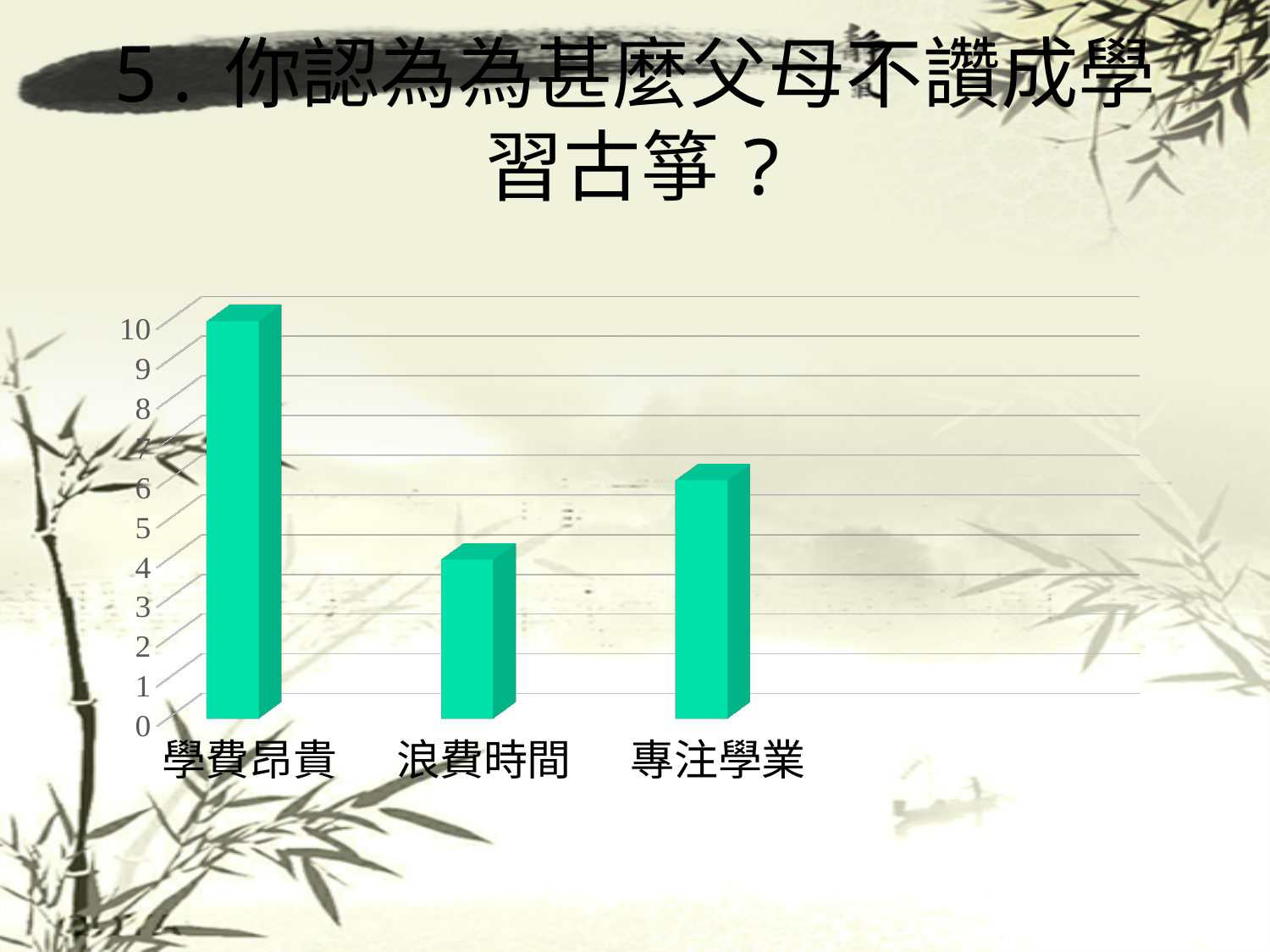
Which is larger, the value for 專注學業 or the value for 浪費時間? 專注學業 What is the difference between the values for 學費昂貴 and 浪費時間? 6 Which category has the lowest bar in the chart? 浪費時間 Is the value for 浪費時間 greater or less than 5? less What kind of chart is shown on the slide? bar chart How many categories are shown on the x axis of the chart? 3 What is the title of the slide containing the chart? 5. 你認為為甚麼父母不讚成學習古箏？ What is the value for 浪費時間? 4 What is the value for 專注學業? 6 What is the value for 學費昂貴? 10 Is the value for 專注學業 greater or less than 5? greater Which category has the highest bar in the chart? 學費昂貴